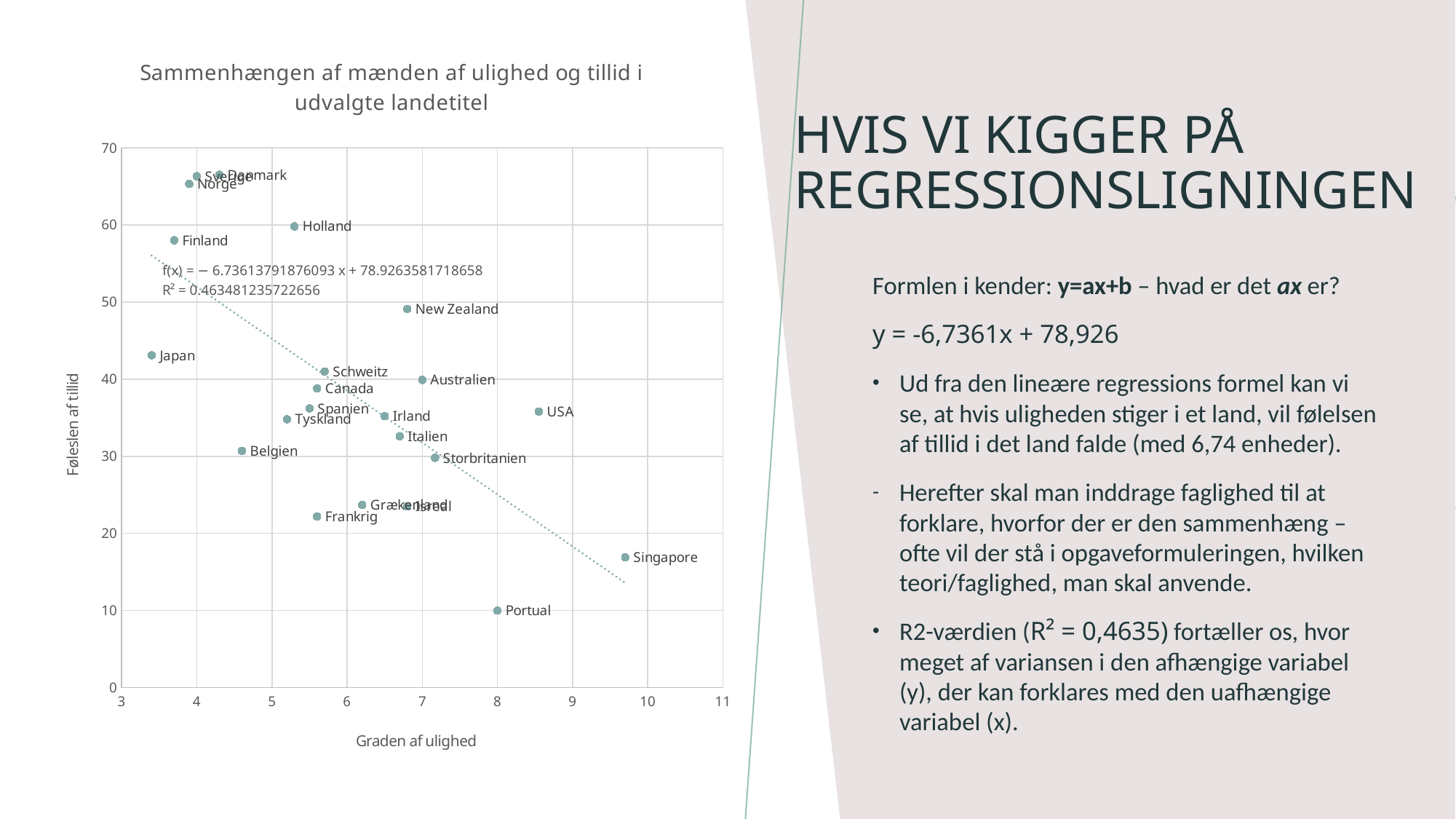
What kind of chart is shown on the slide? scatter chart How many countries are plotted in the chart? 22 What R² value is printed on the chart? 0.463481235722656 What is the title of the x axis of the chart? Graden af ulighed Is the 'Føleslen af tillid' value for Japan greater or less than 40? greater Which country has the highest value on the 'Graden af ulighed' axis? Singapore Does the trendline show trust rising or falling as inequality increases along the x axis? falling Is the 'Graden af ulighed' value for USA greater or less than 8? greater Is the 'Føleslen af tillid' value for Singapore greater or less than 20? less Which country has a higher 'Føleslen af tillid' value, Finland or Belgien? Finland Which country has the lowest value on the 'Føleslen af tillid' axis? Portual What is the 'Føleslen af tillid' value for Portual? 10